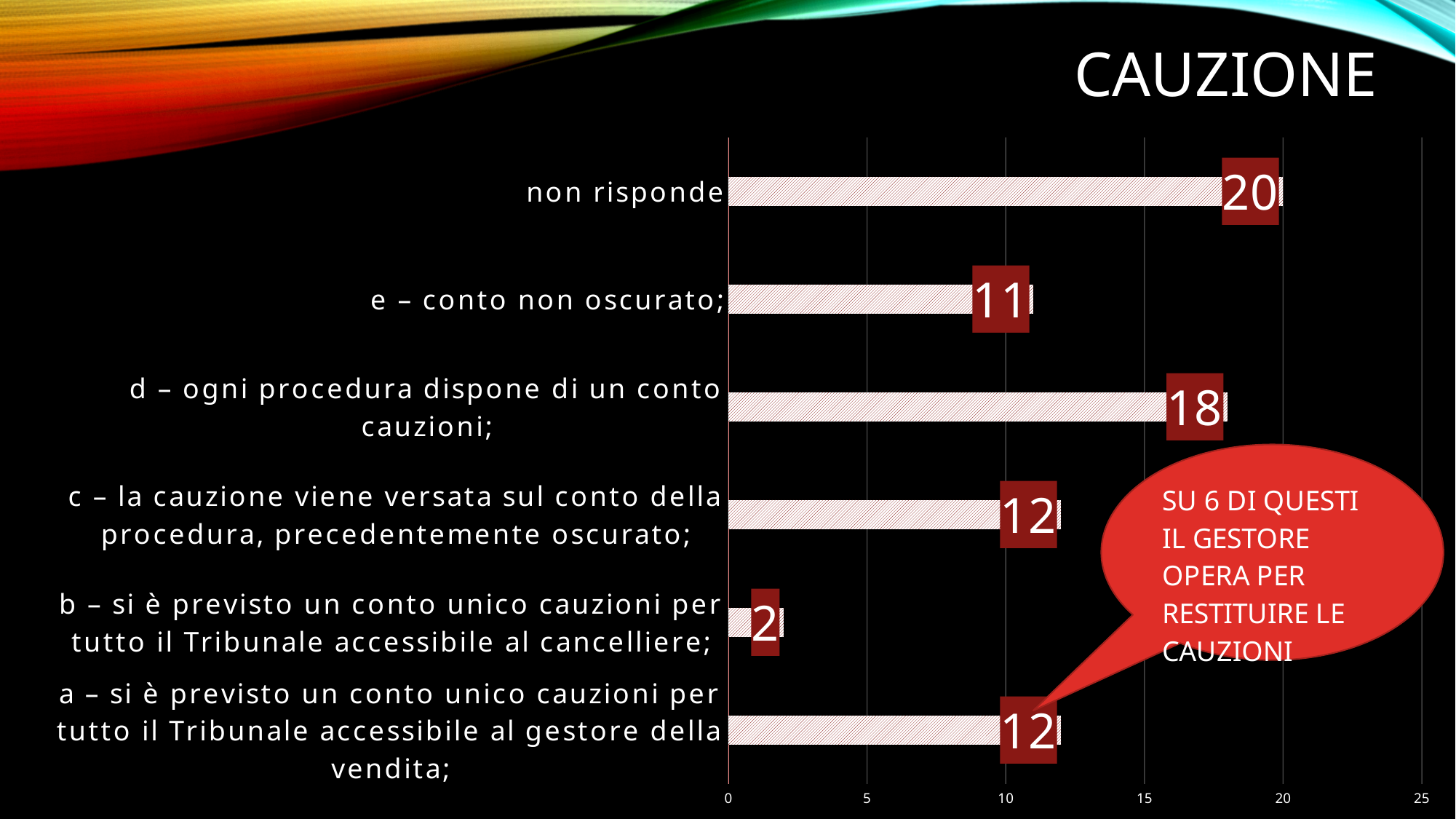
What is the title of the slide containing the chart? CAUZIONE What is the value for "non risponde"? 20 How many categories are shown in the chart? 6 Is the value for "d – ogni procedura dispone di un conto cauzioni" greater or less than 15? greater What kind of chart is shown on the slide? bar chart What is the value for "b – si è previsto un conto unico cauzioni per tutto il Tribunale accessibile al cancelliere"? 2 Which is larger: the value for "e – conto non oscurato" or the value for "c – la cauzione viene versata sul conto della procedura, precedentemente oscurato"? c – la cauzione viene versata sul conto della procedura, precedentemente oscurato Which category has the highest value? non risponde What is the value for "d – ogni procedura dispone di un conto cauzioni"? 18 What is the value for "e – conto non oscurato"? 11 Which category has the lowest value? b – si è previsto un conto unico cauzioni per tutto il Tribunale accessibile al cancelliere What is the difference between the value for "non risponde" and the value for "d – ogni procedura dispone di un conto cauzioni"? 2